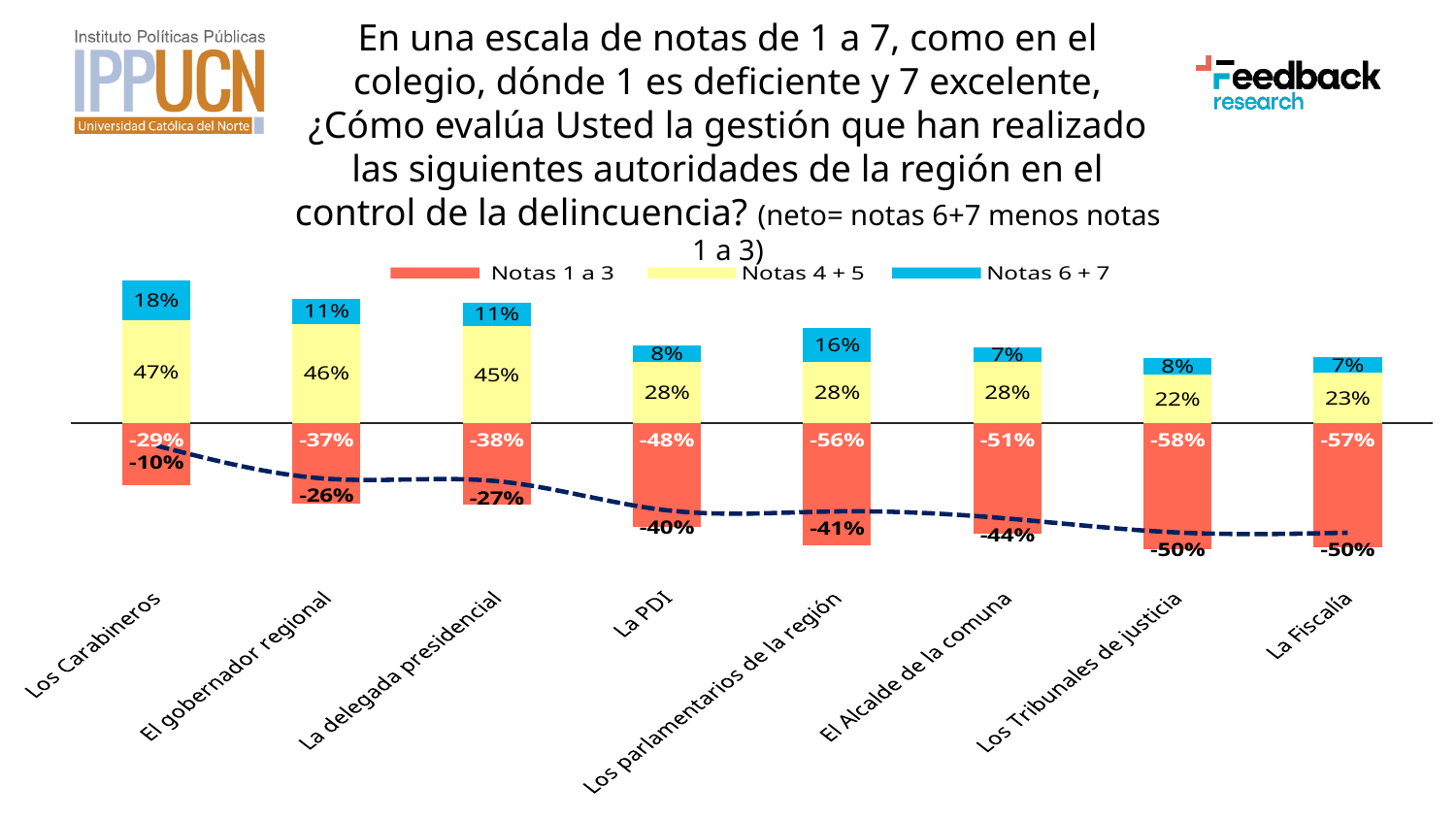
Does the dashed net line rise or fall from left to right across the categories? Fall How many categories (authorities) are shown on the x axis? 8 Which category has the highest Notas 6 + 7 value? Los Carabineros How many series does the legend list? 3 What is the difference between the Notas 6 + 7 values for Los Carabineros and La PDI? 10 percentage points Which is larger, the Notas 4 + 5 value for La delegada presidencial or for La Fiscalía? La delegada presidencial Which category has the lowest Notas 4 + 5 value? Los Tribunales de justicia What is the Notas 6 + 7 value for Los Carabineros? 18% What is the Notas 1 a 3 value for Los parlamentarios de la región? -56% What kind of chart is shown on the slide? Stacked bar chart with a line What is the Notas 4 + 5 value for El gobernador regional? 46% What is the net (neto) value shown for La PDI? -40%